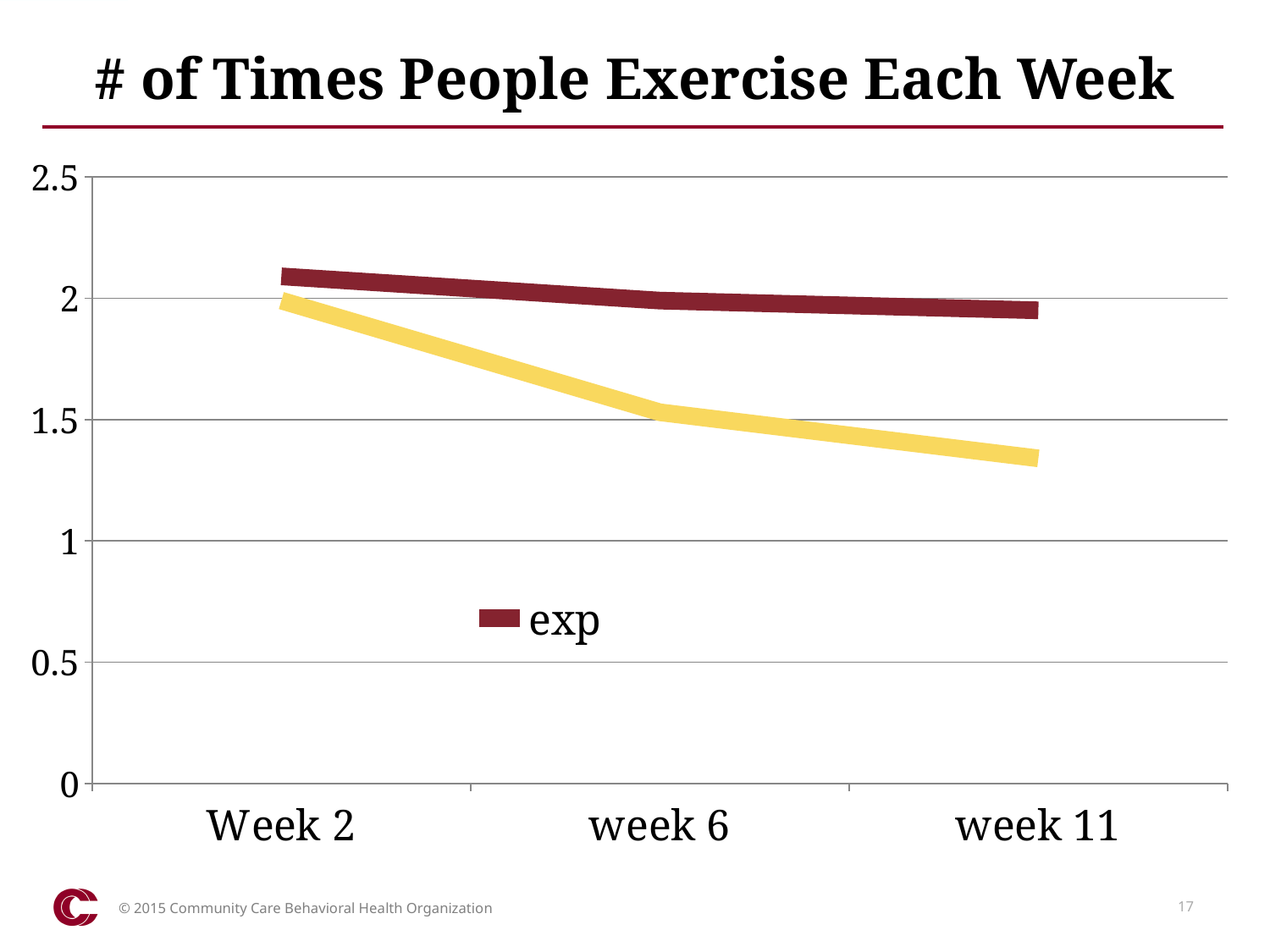
Is the value of the yellow line at week 6 greater or less than 2? less At week 11, which line has the higher value, the exp line or the yellow line? exp Is the value of the exp line at Week 2 greater or less than 2? greater Does the exp line rise or fall from Week 2 to week 11? fall What kind of chart is shown on the slide? line chart Does the yellow line rise or fall from Week 2 to week 11? fall How many points are labelled along the x axis of the chart? 3 How many series does the chart's legend list? 1 At week 6, which line has the lower value, the exp line or the yellow line? the yellow line Is the value of the yellow line at week 11 greater or less than 1.5? less What is the title of the chart? # of Times People Exercise Each Week What is the name of the series listed in the legend? exp